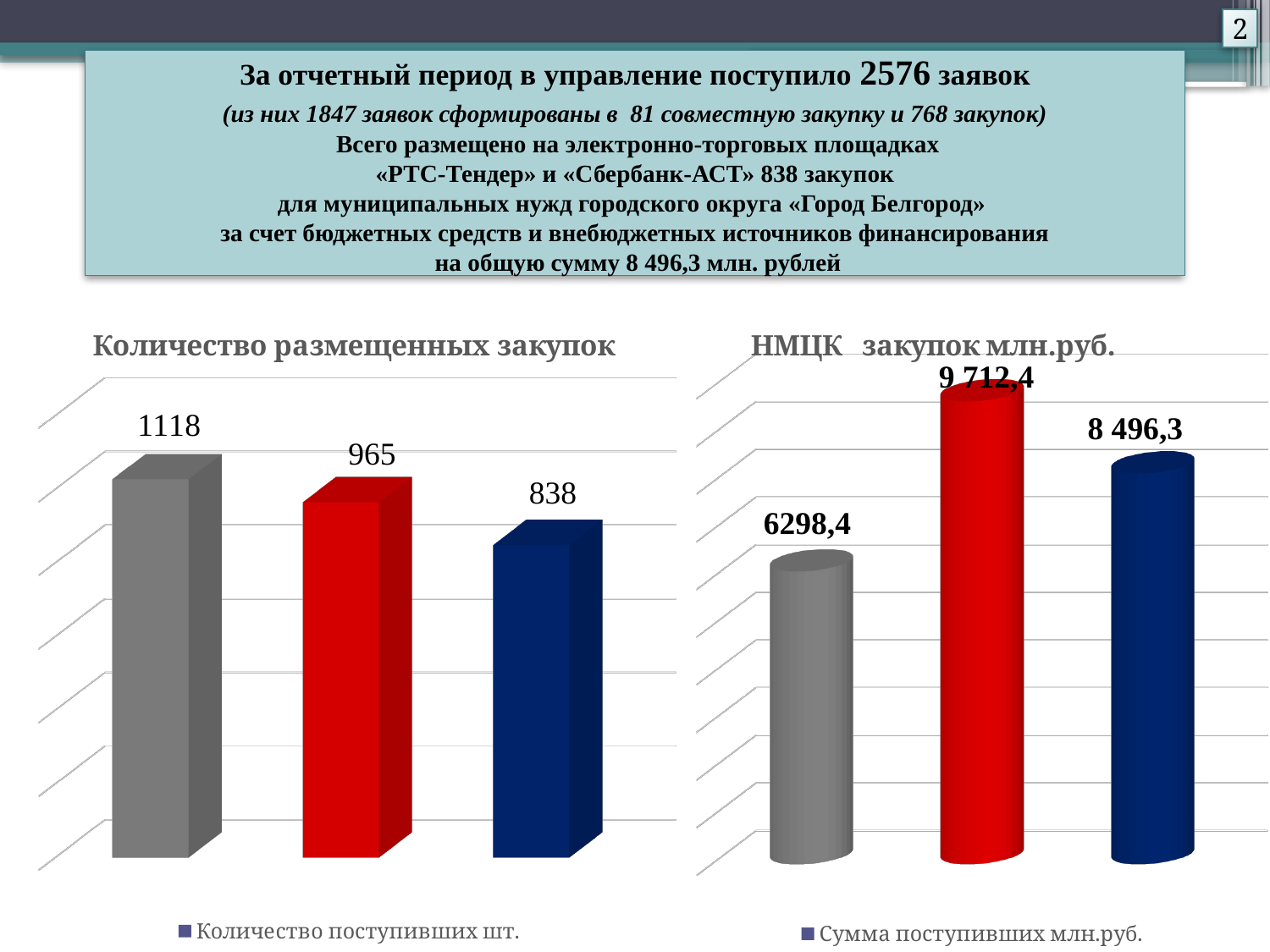
In the chart titled "НМЦК закупок млн.руб.", what value is shown on the red (middle) bar? 9 712,4 In the chart titled "Количество размещенных закупок", what value is shown on the red (middle) bar? 965 What type of chart is the chart titled "Количество размещенных закупок"? bar chart In the chart titled "Количество размещенных закупок", do the values rise or fall from left to right? fall In the chart titled "НМЦК закупок млн.руб.", what value is shown on the blue (third) bar? 8 496,3 In the chart titled "НМЦК закупок млн.руб.", which bar has the lowest value? the grey (first) bar, 6298,4 In the chart titled "НМЦК закупок млн.руб.", what value is shown on the grey (first) bar? 6298,4 In the chart titled "НМЦК закупок млн.руб.", which is larger: the red bar or the blue bar? the red bar (9 712,4) In the chart titled "Количество размещенных закупок", which bar has the highest value? the grey (first) bar, 1118 In the chart titled "Количество размещенных закупок", what value is shown on the blue (third) bar? 838 In the chart titled "Количество размещенных закупок", what value is shown on the grey (first) bar? 1118 In the chart titled "Количество размещенных закупок", what is the difference between the first bar and the third bar? 280